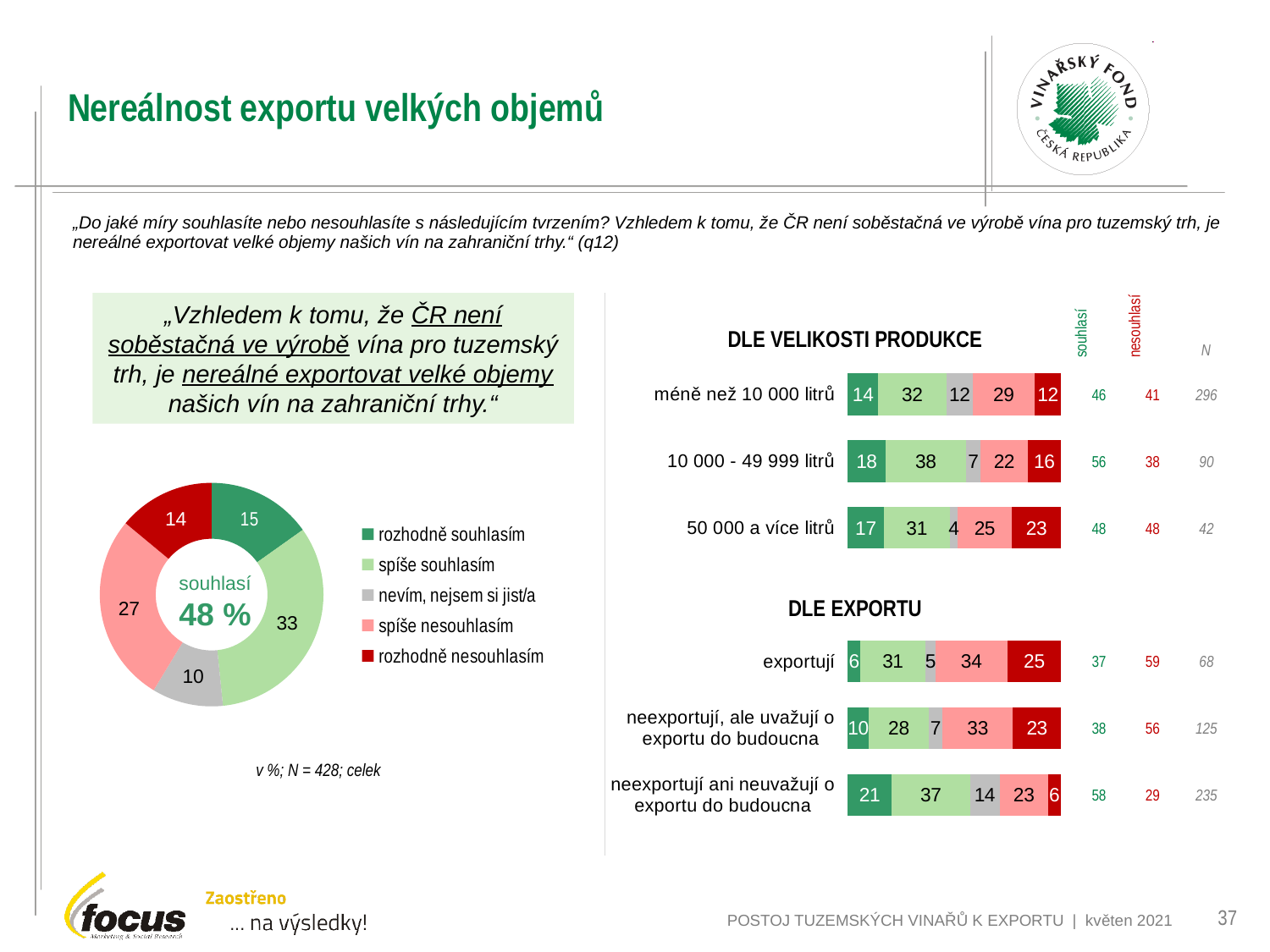
In the "DLE EXPORTU" chart, what is the "rozhodně souhlasím" value for "neexportují ani neuvažují o exportu do budoucna"? 21 In the donut chart on the left, what is the value for "spíše souhlasím"? 33 In the "DLE VELIKOSTI PRODUKCE" chart, what is the difference between the "spíše nesouhlasím" values for "méně než 10 000 litrů" and "10 000 - 49 999 litrů"? 7 How many categories (bars) does the "DLE EXPORTU" chart show? 3 In the donut chart on the left, which category has the smallest value? nevím, nejsem si jist/a What type of chart is used for "DLE VELIKOSTI PRODUKCE"? stacked bar chart In the "DLE EXPORTU" chart, which category has the lowest "rozhodně nesouhlasím" value? neexportují ani neuvažují o exportu do budoucna In the "DLE VELIKOSTI PRODUKCE" chart, what is the "rozhodně nesouhlasím" value for "50 000 a více litrů"? 23 In the donut chart on the left, what percentage is shown in the centre as "souhlasí"? 48 % In the "DLE VELIKOSTI PRODUKCE" chart, which category has the highest "spíše souhlasím" value? 10 000 - 49 999 litrů In the "DLE EXPORTU" chart, is the "spíše nesouhlasím" value larger for "exportují" or for "neexportují, ale uvažují o exportu do budoucna"? exportují How many entries does the legend of the donut chart on the left list? 5